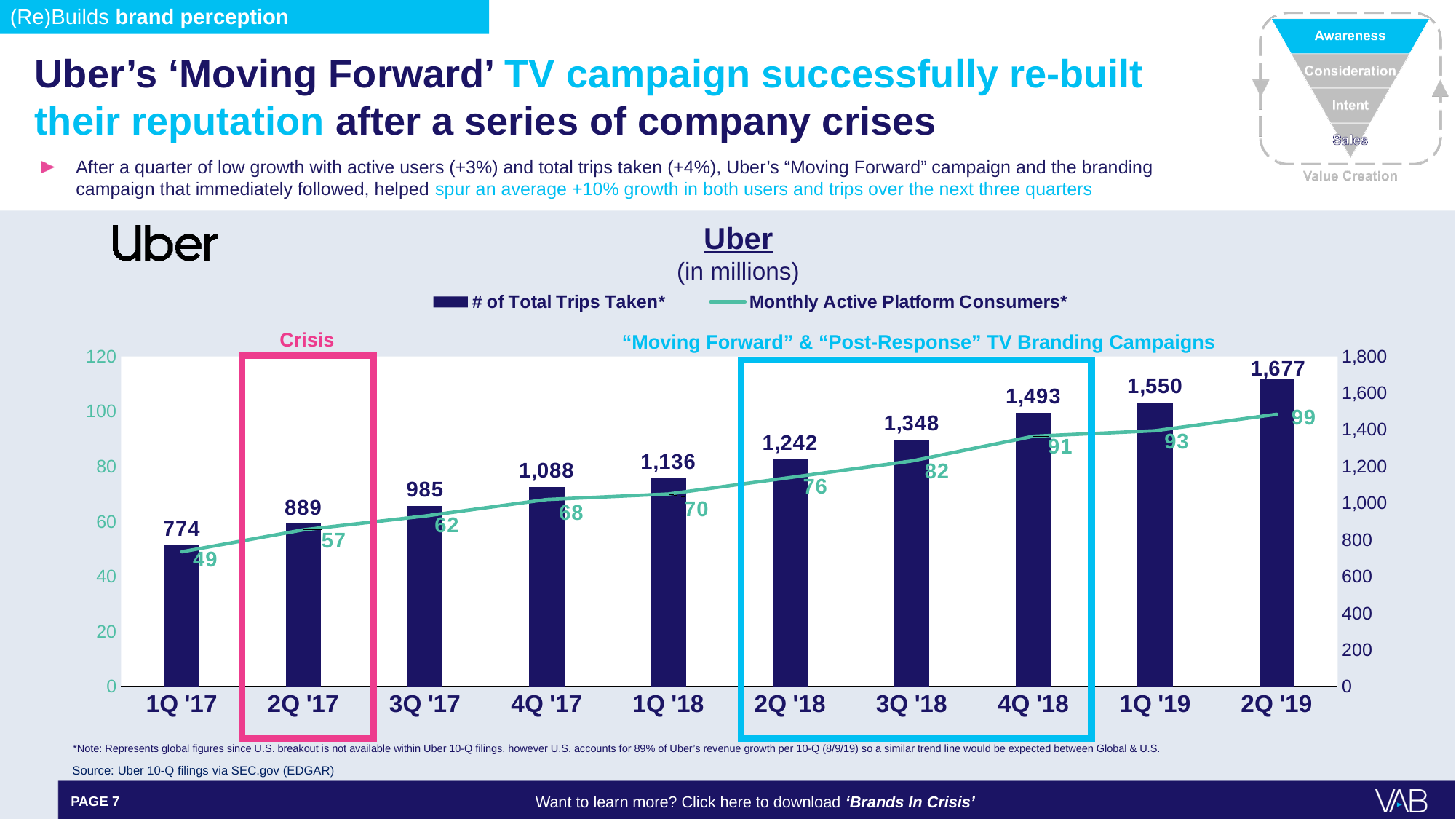
What is the difference in # of Total Trips Taken between 2Q '19 and 1Q '19? 127 What is the difference in Monthly Active Platform Consumers between 2Q '18 and 1Q '18? 6 What kind of chart is used to show the # of Total Trips Taken? Bar chart What is the # of Total Trips Taken for 2Q '17? 889 How many quarters are shown on the x axis? 10 Which is larger, the # of Total Trips Taken in 3Q '18 or in 4Q '17? 3Q '18 Which quarter is highlighted with the pink 'Crisis' box? 2Q '17 Which quarter has the lowest Monthly Active Platform Consumers value? 1Q '17 What is the Monthly Active Platform Consumers value for 4Q '18? 91 How many series does the legend list? 2 Which quarter has the highest # of Total Trips Taken? 2Q '19 Do the Monthly Active Platform Consumers values rise or fall from 1Q '17 to 2Q '19? Rise